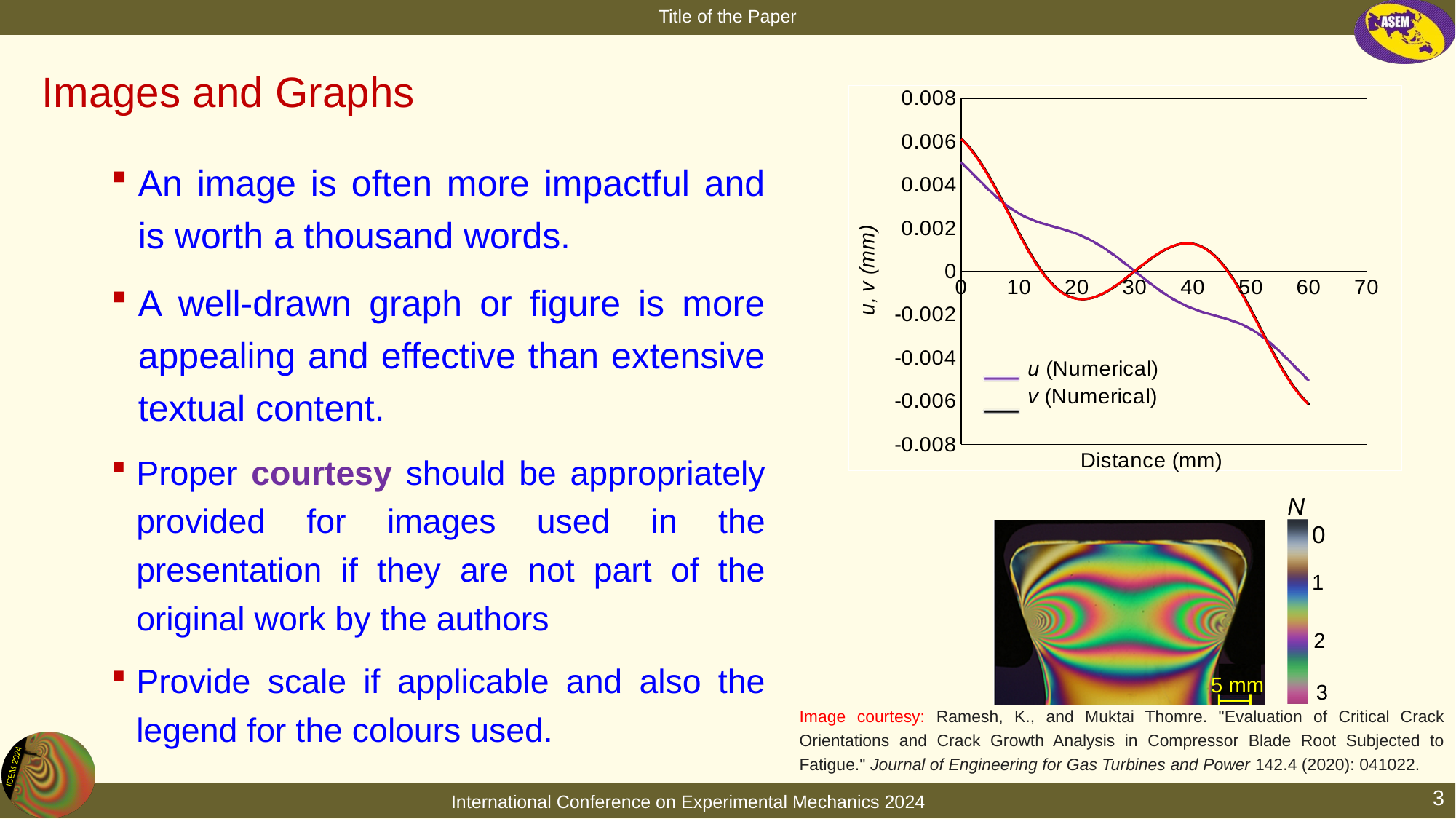
Is the value of v (Numerical) at a distance of 40 mm greater or less than 0? greater At a distance of 0 mm, which series has the higher value, u (Numerical) or v (Numerical)? v (Numerical) What is the title of the chart's x axis? Distance (mm) What are the two series named in the chart's legend? u (Numerical) and v (Numerical) Is the value of v (Numerical) at a distance of 20 mm greater or less than 0? less What is the largest value shown on the chart's x axis? 70 Is the value of v (Numerical) at a distance of 60 mm greater or less than -0.004? less Does the u (Numerical) series rise or fall as distance increases from 0 to 60 mm? fall How many series does the chart's legend list? 2 At a distance of 20 mm, which series has the higher value, u (Numerical) or v (Numerical)? u (Numerical) What kind of chart is shown on the slide? line chart